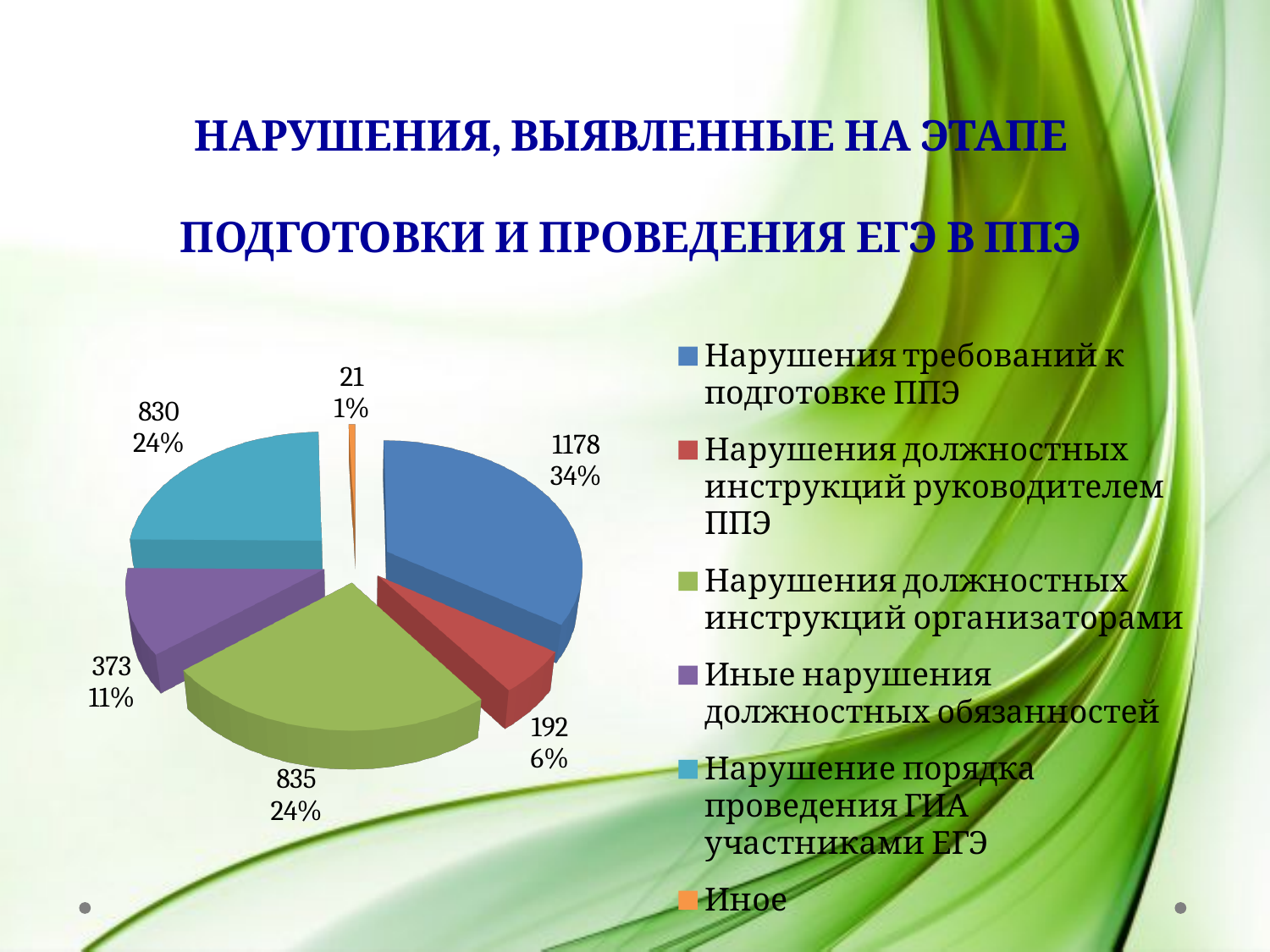
What is the value for "Нарушения требований к подготовке ППЭ"? 1178 What is the value for "Нарушения должностных инструкций руководителем ППЭ"? 192 Which is larger: the value for "Иные нарушения должностных обязанностей" or the value for "Нарушения должностных инструкций руководителем ППЭ"? Иные нарушения должностных обязанностей What kind of chart is shown on the slide? pie chart Which category has the largest value? Нарушения требований к подготовке ППЭ How many entries does the legend list? 6 Which category has the smallest value? Иное What is the difference between the values for "Нарушения требований к подготовке ППЭ" and "Нарушения должностных инструкций организаторами"? 343 What share of the pie does "Нарушение порядка проведения ГИА участниками ЕГЭ" represent? 24% What share of the pie does "Иное" represent? 1% What is the value for "Иные нарушения должностных обязанностей"? 373 How many slices does the pie chart have? 6